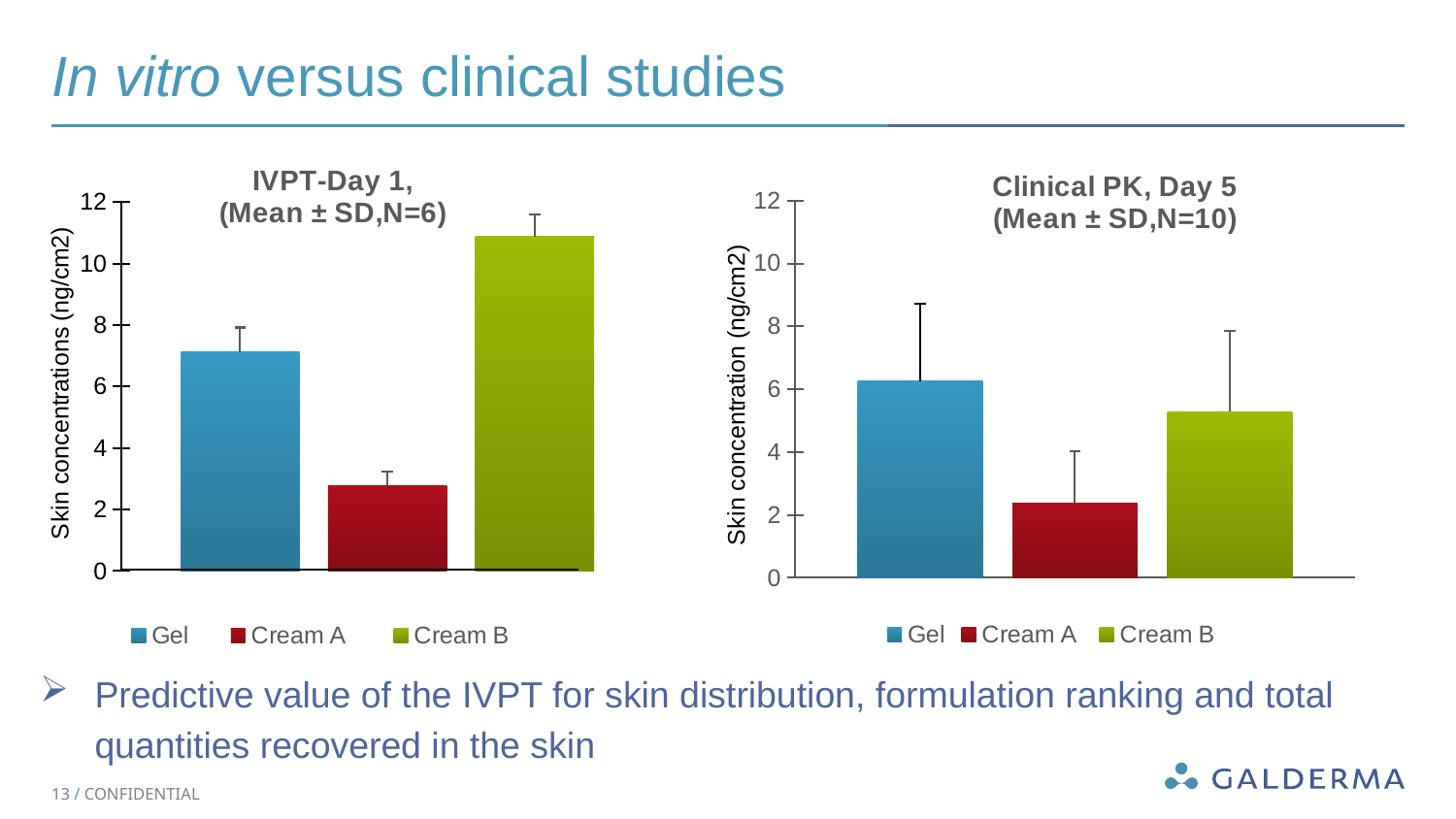
What kind of chart is the IVPT-Day 1 chart? Bar chart In the Clinical PK, Day 5 chart, which formulation has the lowest skin concentration? Cream A In the Clinical PK, Day 5 chart, is the value for Cream B greater or less than 6? less In the IVPT-Day 1 chart, which formulation has the highest skin concentration? Cream B In the Clinical PK, Day 5 chart, which formulation has the highest skin concentration? Gel In the IVPT-Day 1 chart, which formulation has the lowest skin concentration? Cream A What is the y-axis label of the IVPT-Day 1 chart? Skin concentrations (ng/cm2) How many series does the legend of the Clinical PK, Day 5 chart list? 3 In the Clinical PK, Day 5 chart, is the value for Gel greater or less than 6? greater In the Clinical PK, Day 5 chart, which is larger, the value for Gel or the value for Cream B? Gel In the IVPT-Day 1 chart, is the value for Cream B greater or less than 10? greater